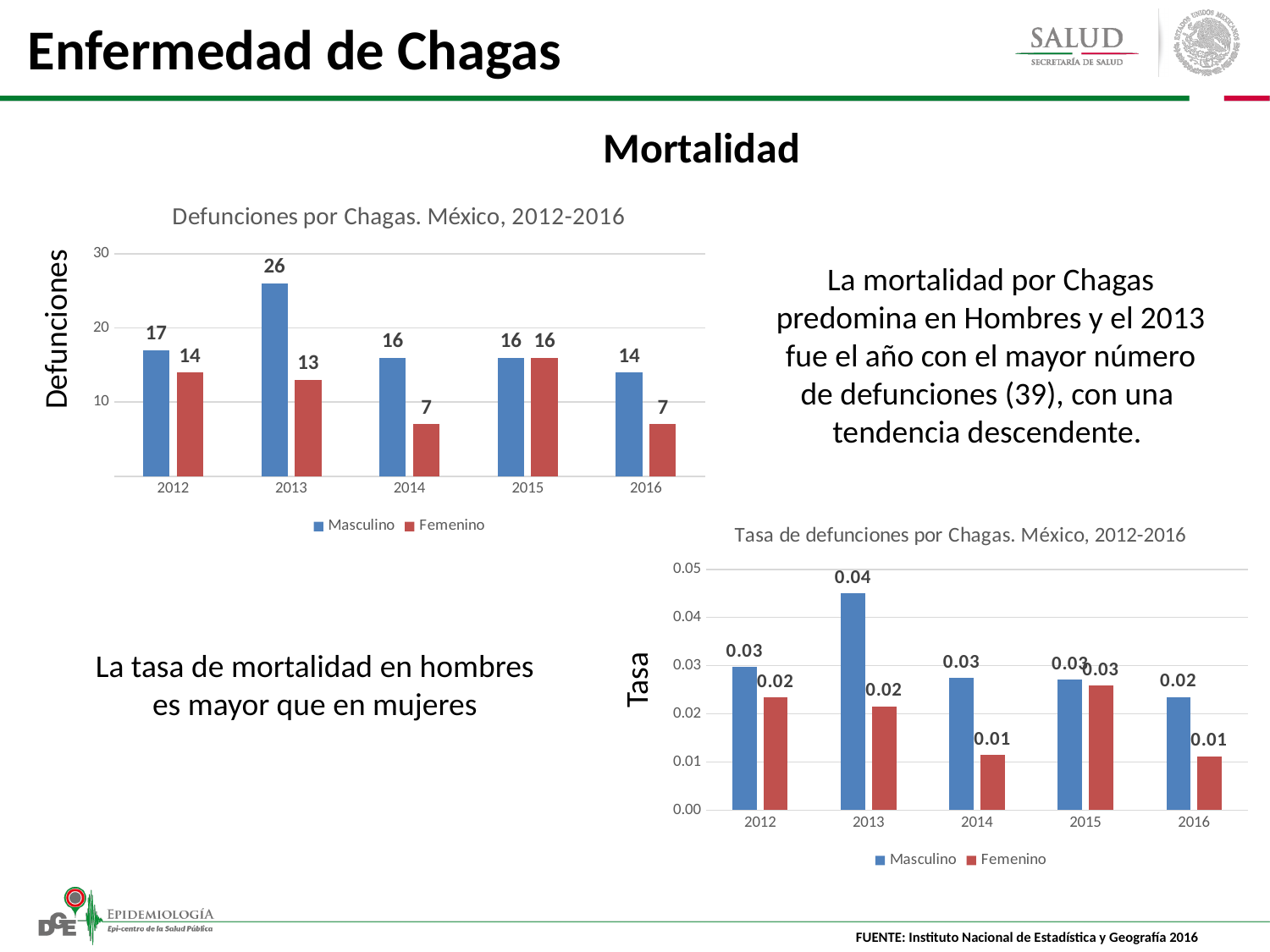
In the chart 'Tasa de defunciones por Chagas. México, 2012-2016', what colour are the Femenino bars? red In the chart 'Tasa de defunciones por Chagas. México, 2012-2016', what is the Masculino value for 2013? 0.04 In the chart 'Defunciones por Chagas. México, 2012-2016', which year has the highest Masculino value? 2013 In the chart 'Defunciones por Chagas. México, 2012-2016', how many series does the legend list? 2 In the chart 'Defunciones por Chagas. México, 2012-2016', is the Masculino value for 2012 greater or less than the Femenino value for 2012? greater In the chart 'Defunciones por Chagas. México, 2012-2016', what is the Femenino value for 2014? 7 In the chart 'Defunciones por Chagas. México, 2012-2016', how many years are shown on the x axis? 5 What kind of chart is 'Tasa de defunciones por Chagas. México, 2012-2016'? bar chart In the chart 'Defunciones por Chagas. México, 2012-2016', what is the Masculino value for 2013? 26 In the chart 'Defunciones por Chagas. México, 2012-2016', what is the difference between the Masculino and Femenino values in 2013? 13 In the chart 'Tasa de defunciones por Chagas. México, 2012-2016', what is the Femenino value for 2016? 0.01